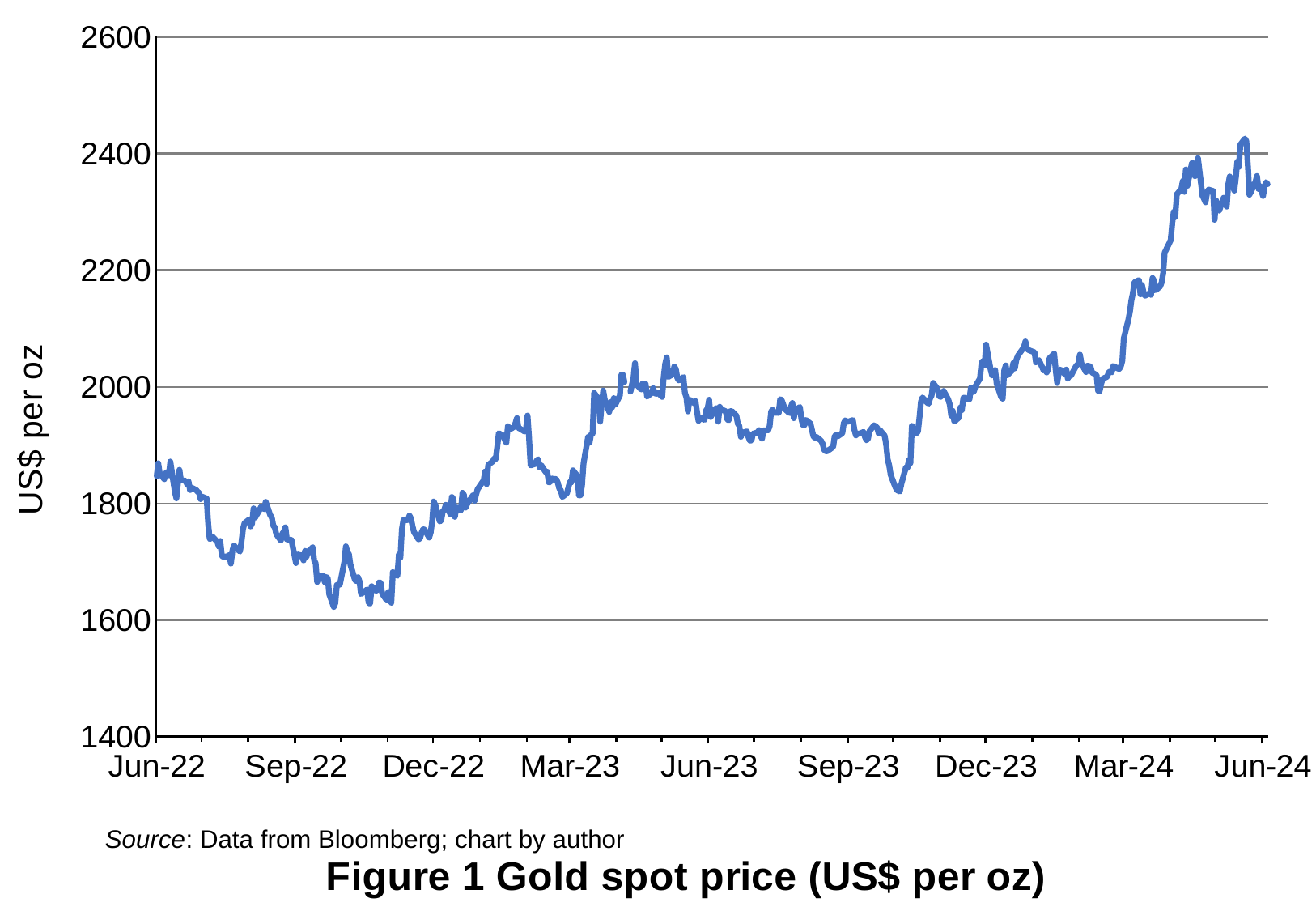
Which is larger, the value at Jun-22 or the value at Jun-24? Jun-24 What kind of chart is shown on the slide? line chart Is the lowest point of the line greater or less than 1600? greater Which is larger, the value at Sep-22 or the value at Sep-23? Sep-23 Is the value at Jun-24 greater or less than 2200? greater How many date labels are shown along the x axis? 9 What is the title of the chart? Figure 1 Gold spot price (US$ per oz) Is the value at Jun-23 greater or less than 2000? less Overall, does the gold spot price rise or fall from Jun-22 to Jun-24? rise What is the label on the vertical axis? US$ per oz